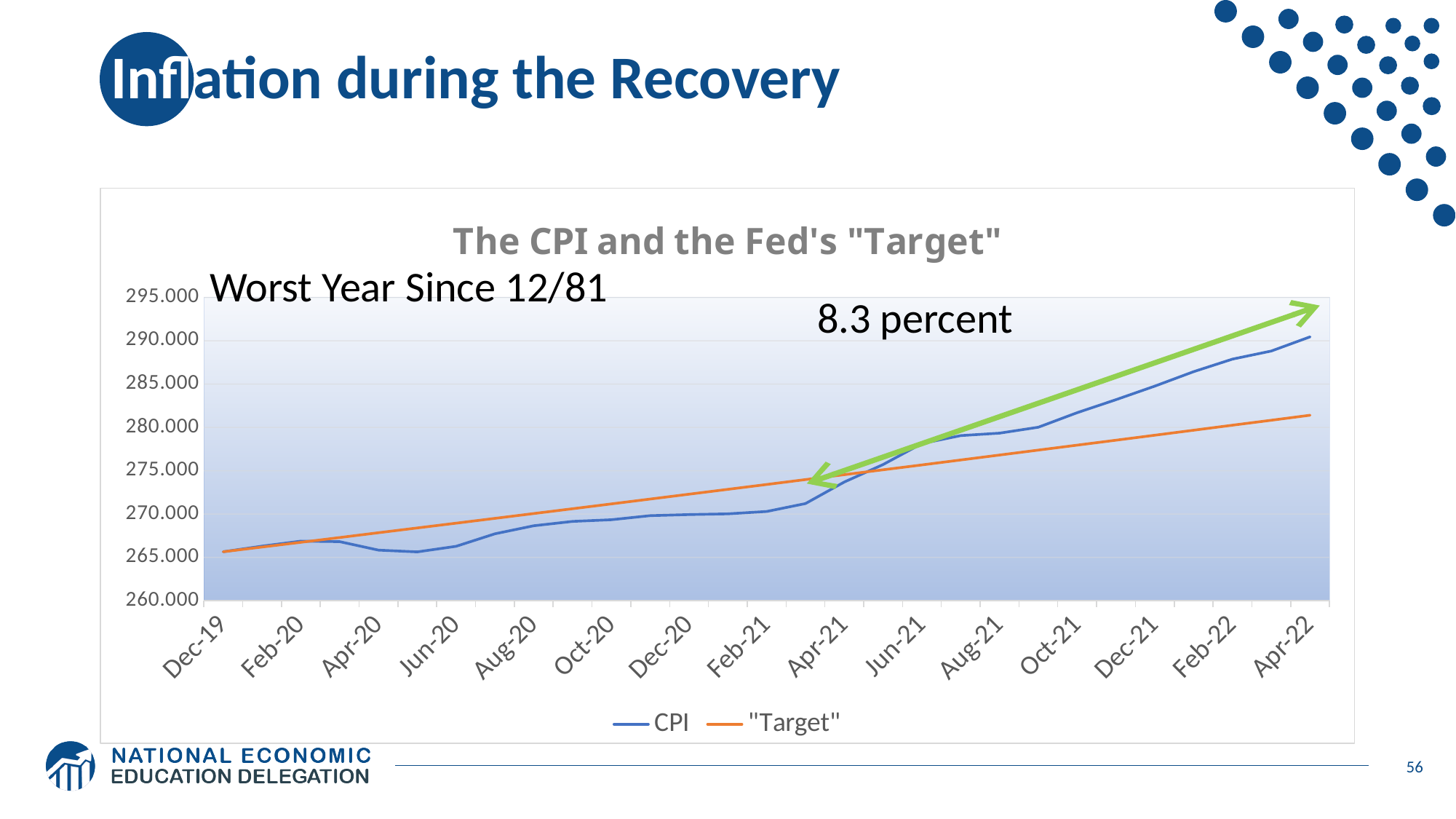
What percentage figure is annotated on the chart next to the green arrow? 8.3 percent Is the CPI value at Jun-20 greater or less than 270.000? less At Apr-22, which series has the higher value, CPI or "Target"? CPI How many series does the chart's legend list? 2 Is the "Target" value at Apr-22 greater or less than 285.000? less What kind of chart is shown on the slide? line chart Does the CPI line generally rise or fall from Dec-19 to Apr-22? rise At Jun-20, which series has the higher value, CPI or "Target"? "Target" How many month labels are shown along the x axis? 15 What is the title of the chart? The CPI and the Fed's "Target" Is the CPI value at Aug-21 greater or less than 275.000? greater